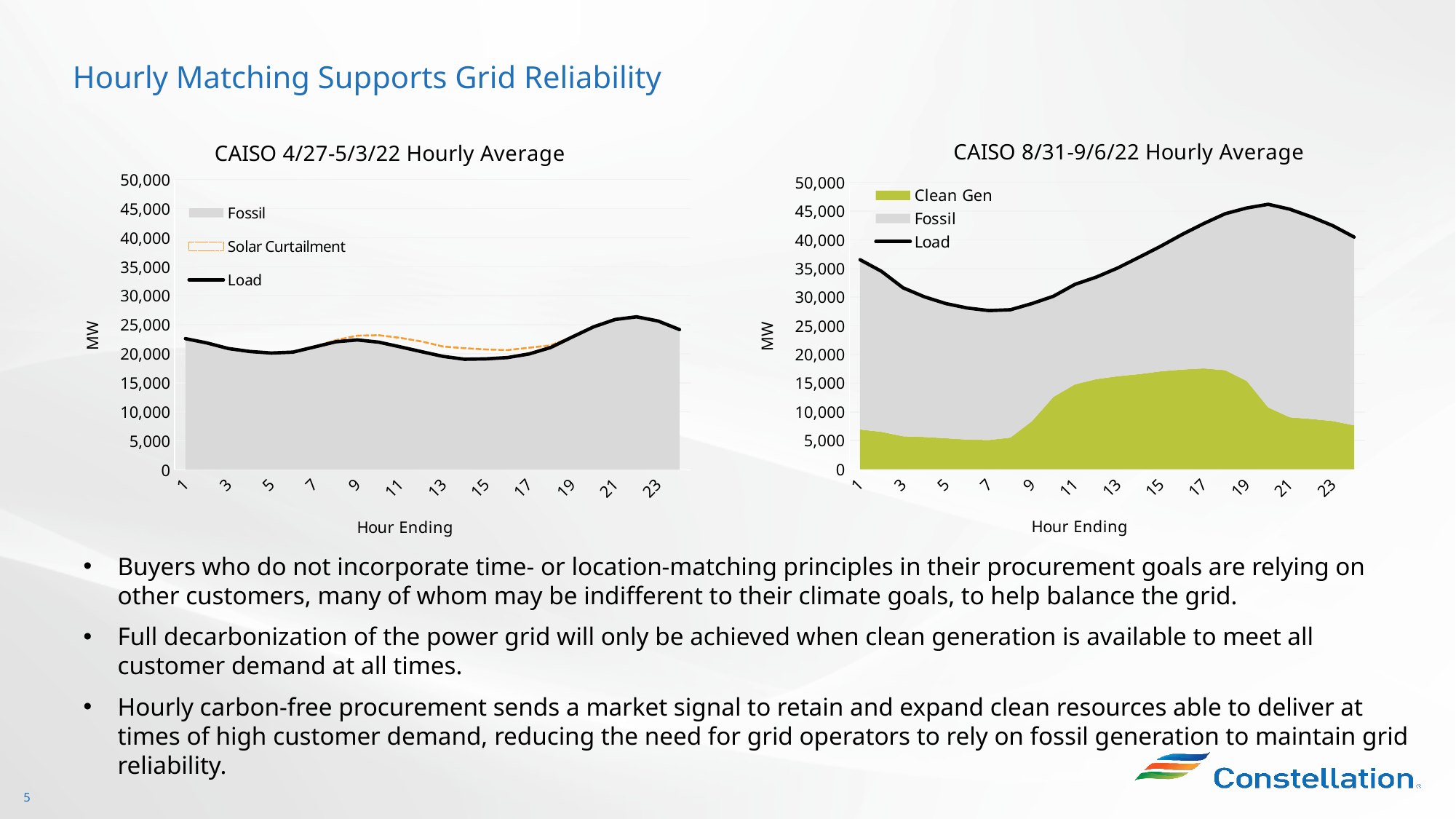
In the CAISO 8/31-9/6/22 Hourly Average chart, is the Clean Gen value at hour ending 3 greater or less than 10,000? less In the CAISO 8/31-9/6/22 Hourly Average chart, does the Load rise or fall from hour ending 7 to hour ending 19? rise In the CAISO 8/31-9/6/22 Hourly Average chart, is the Clean Gen value at hour ending 15 greater or less than 15,000? greater In the CAISO 8/31-9/6/22 Hourly Average chart, is the Load value at hour ending 7 greater or less than 30,000? less In the CAISO 4/27-5/3/22 Hourly Average chart, which series is shown as a dashed orange line? Solar Curtailment How many series does the legend of the CAISO 8/31-9/6/22 Hourly Average chart list? 3 In the CAISO 8/31-9/6/22 Hourly Average chart, which series is shown in green? Clean Gen What kind of chart is the CAISO 4/27-5/3/22 Hourly Average chart? Area chart with a line In the CAISO 4/27-5/3/22 Hourly Average chart, at which hour ending does Load reach its highest value? 22